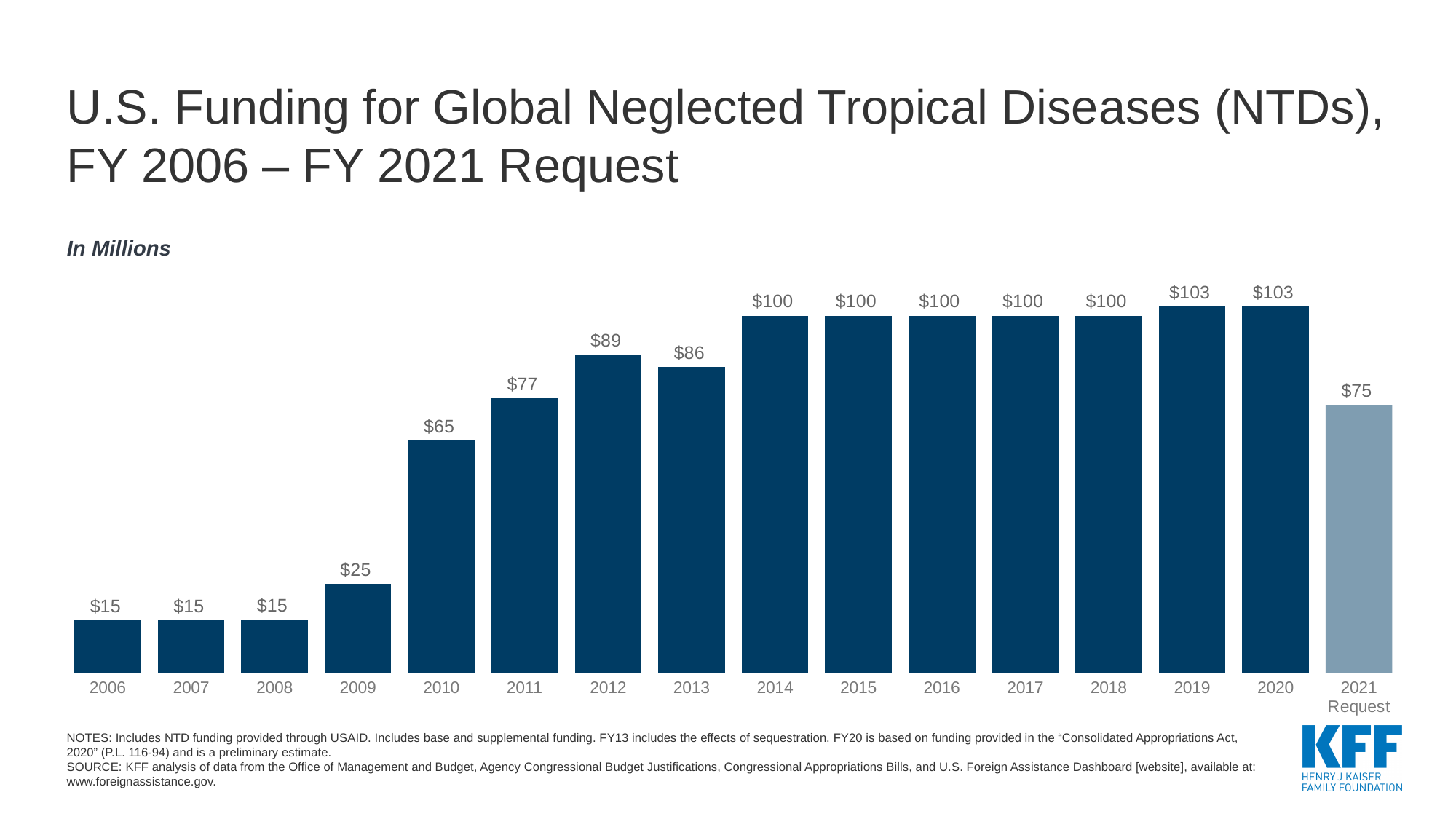
Which year has the lowest funding value? 2006, 2007 and 2008 (tied at $15) What is the difference between the 2020 value and the 2021 Request value? $28 What is the value for 2013? $86 Do the values generally rise or fall from 2006 to 2020? Rise What is the highest value shown on the chart? $103 What unit is stated for the values on the chart? In Millions What kind of chart is this? Bar chart What is the difference between the 2012 value and the 2013 value? $3 What is the value for the 2021 Request? $75 Which is larger, the value for 2011 or the value for 2012? 2012 What is the value for 2010? $65 How many bars are shown on the chart? 16